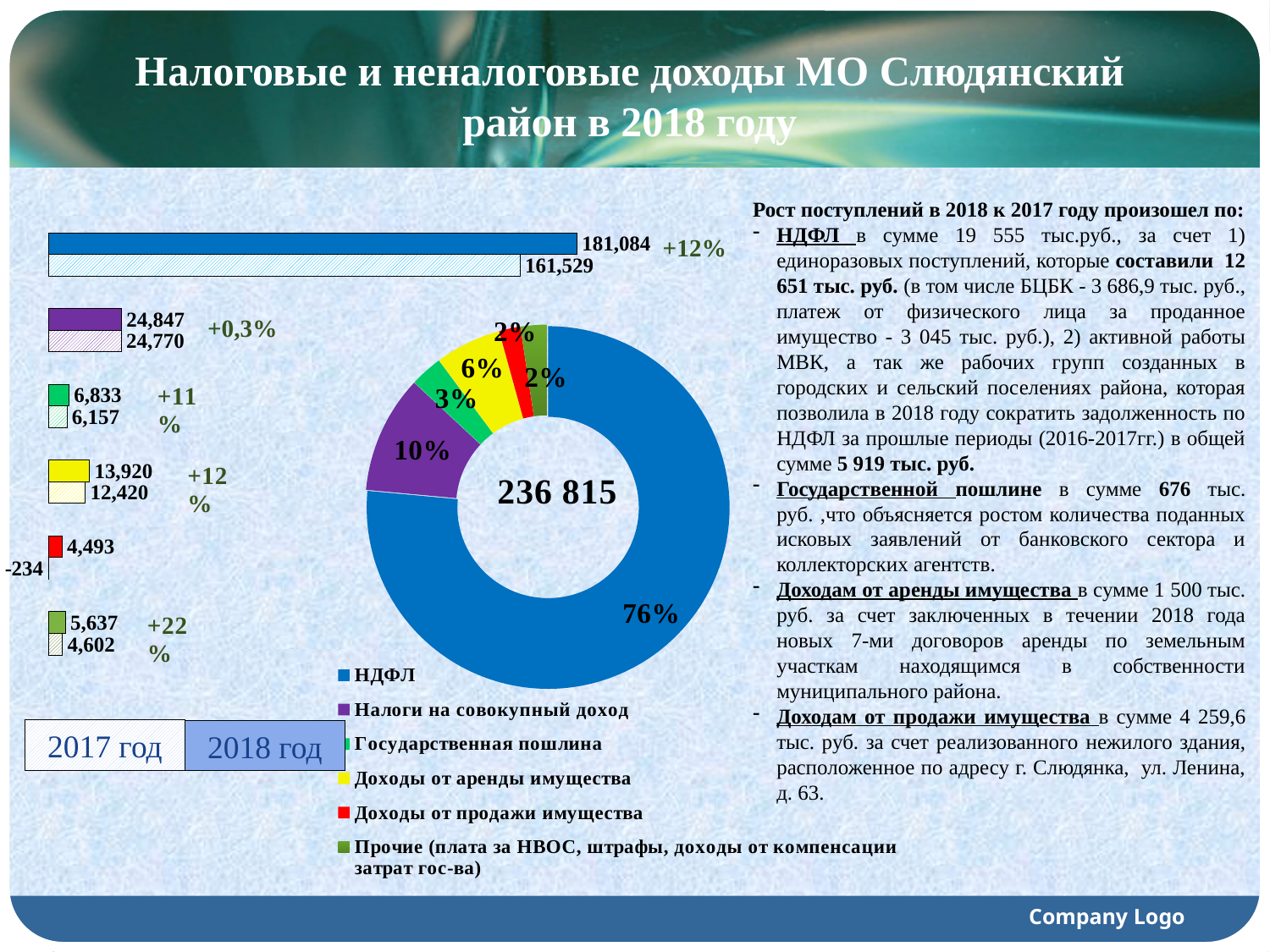
What total is printed in the centre of the doughnut chart? 236 815 In the bar chart on the left, what percentage change is shown next to the Прочие (olive) bars? +22% How many categories does the legend of the doughnut chart list? 6 In the bar chart on the left, what is the 2017 value for НДФЛ? 161,529 In the bar chart on the left, which is larger: the 2018 value for Прочие (olive bars) or the 2018 value for Доходы от продажи имущества (red bars)? Прочие In the bar chart on the left, what is the 2017 value for Государственная пошлина (green bars)? 6,157 In the doughnut chart in the middle, what share does НДФЛ have? 76% In the doughnut chart in the middle, what share does Налоги на совокупный доход have? 10% In the bar chart on the left, what is the difference between the 2018 and 2017 values for Налоги на совокупный доход (purple bars)? 77 In the bar chart on the left, which category has the highest 2018 value? НДФЛ In the bar chart on the left, what is the 2018 value for НДФЛ? 181,084 In the bar chart on the left, what is the 2018 value for Доходы от аренды имущества (yellow bars)? 13,920